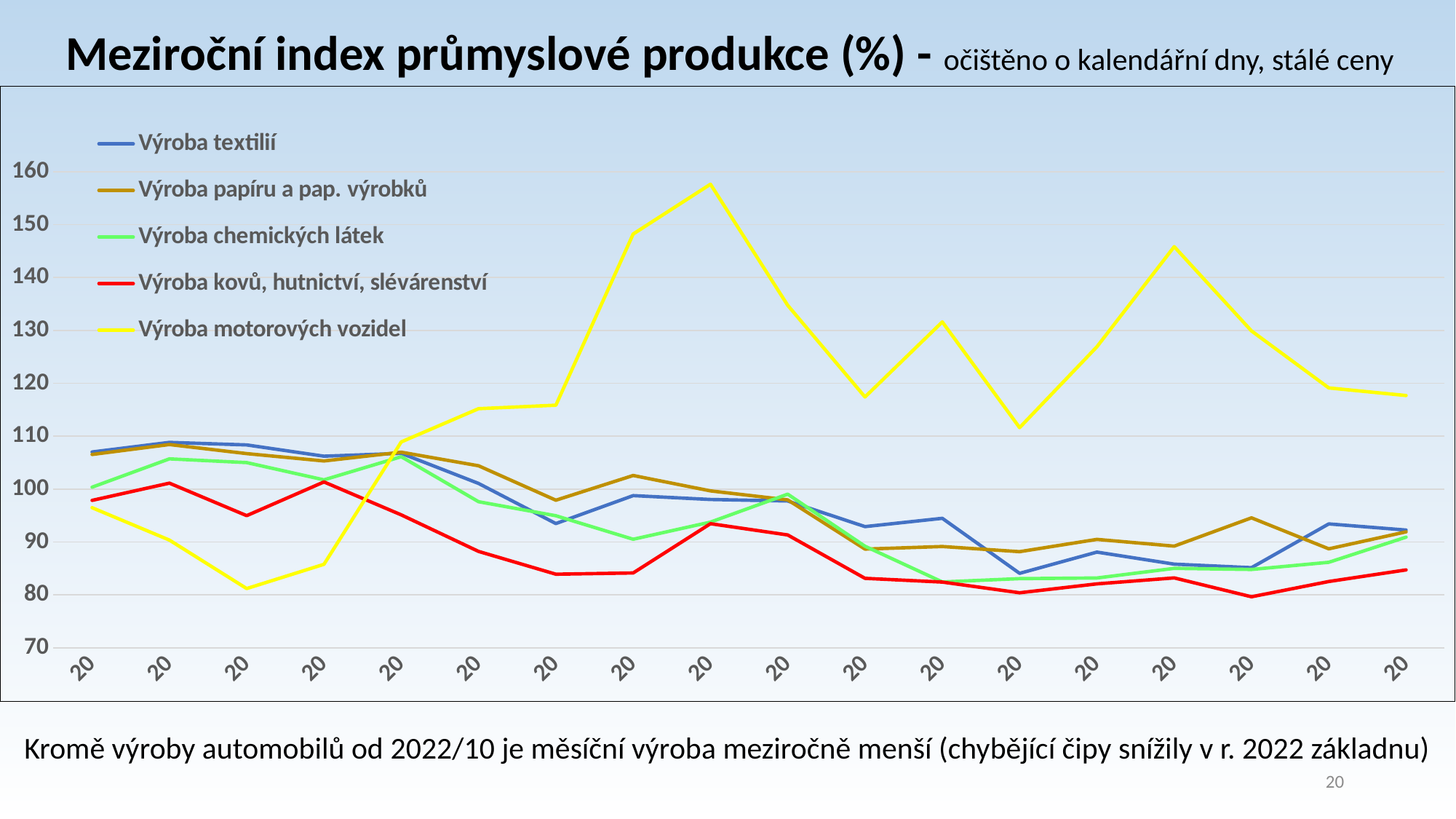
What kind of chart is shown on the slide? line chart Is the lowest value of the Výroba kovů, hutnictví, slévárenství series greater or less than 90? less Which series is drawn in yellow? Výroba motorových vozidel How many series does the legend list? 5 Is the last value of the Výroba motorových vozidel series greater or less than 110? greater At the last point on the x axis, which is higher: Výroba textilií or Výroba kovů, hutnictví, slévárenství? Výroba textilií Does the Výroba kovů, hutnictví, slévárenství series rise or fall overall from the first point to the last point? fall Is the highest value of the Výroba motorových vozidel series greater or less than 150? greater What colour is the line for Výroba kovů, hutnictví, slévárenství? red Which series reaches the highest value anywhere on the chart? Výroba motorových vozidel How many data points does each line have along the x axis? 18